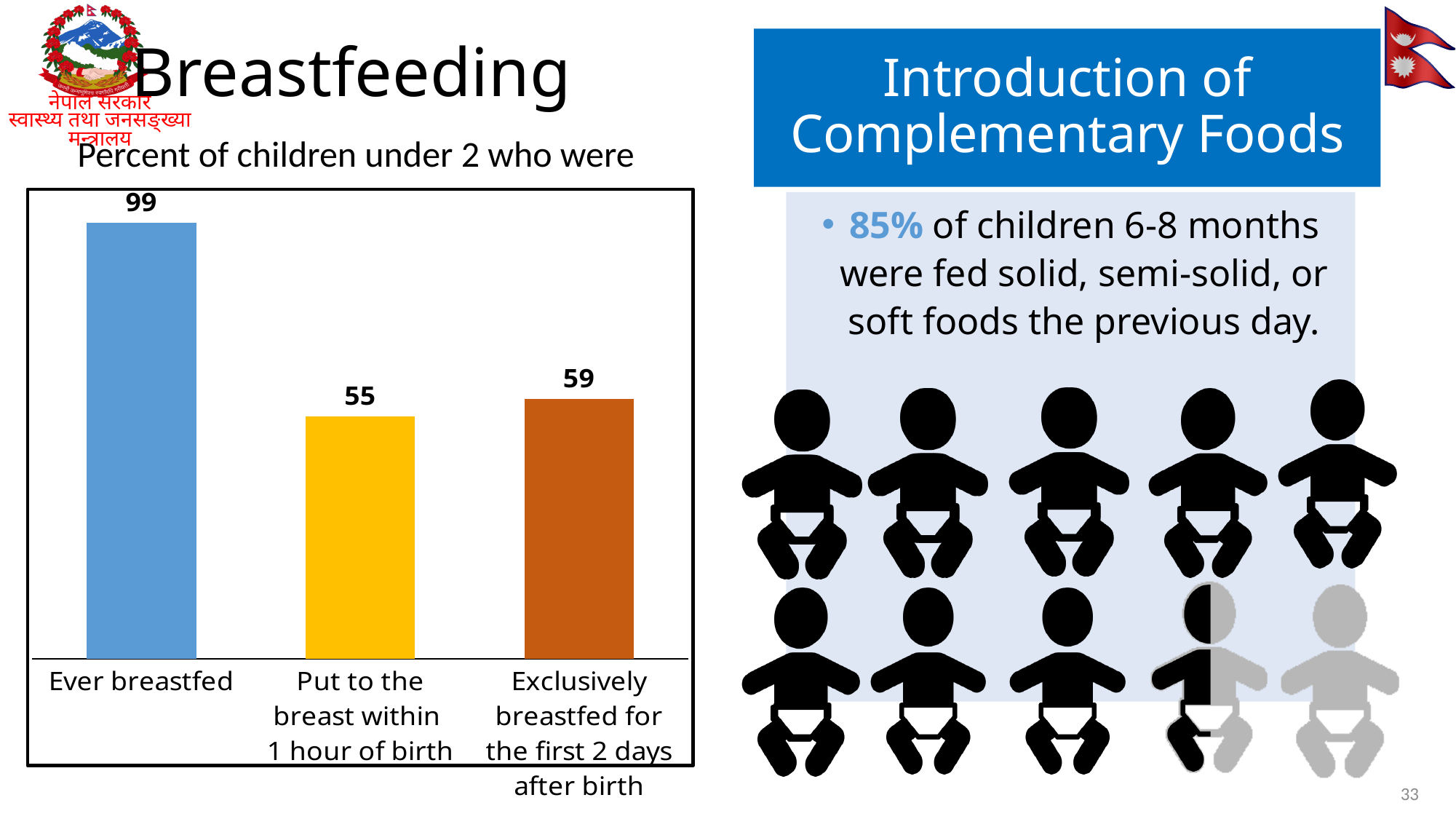
What is the title of the chart? Percent of children under 2 who were Which category has the lowest value? Put to the breast within 1 hour of birth What colour is the bar for 'Put to the breast within 1 hour of birth'? Yellow What is the value for 'Exclusively breastfed for the first 2 days after birth'? 59 What kind of chart is shown on the slide? Bar chart Which is larger: the value for 'Ever breastfed' or for 'Exclusively breastfed for the first 2 days after birth'? Ever breastfed Which category has the highest value? Ever breastfed How many categories are shown in the chart? 3 What is the difference between the values for 'Ever breastfed' and 'Put to the breast within 1 hour of birth'? 44 What is the value for 'Ever breastfed'? 99 What is the value for 'Put to the breast within 1 hour of birth'? 55 What is the difference between the values for 'Exclusively breastfed for the first 2 days after birth' and 'Put to the breast within 1 hour of birth'? 4